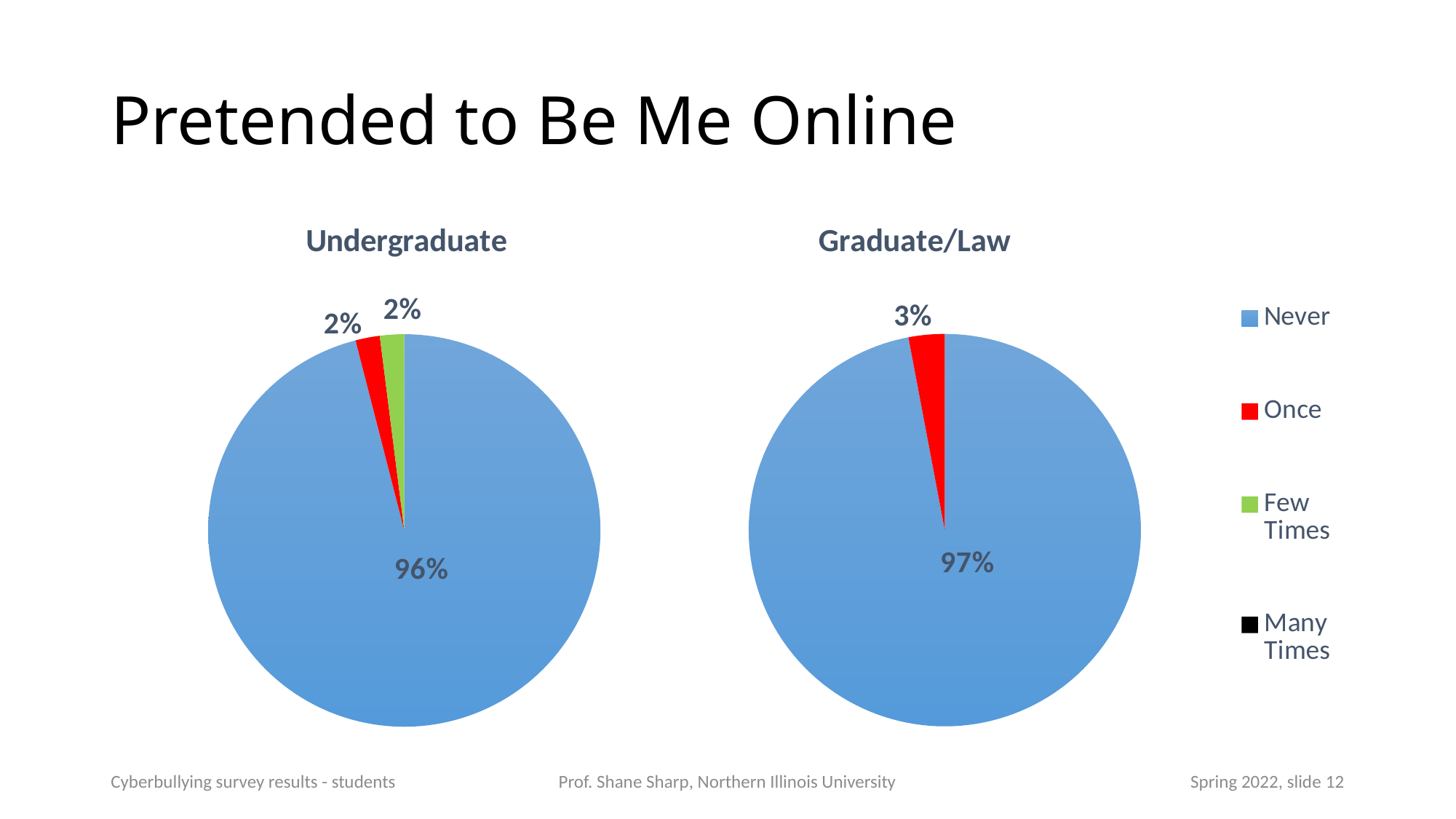
In the Graduate/Law chart, what share of respondents answered Once? 3% In the Undergraduate chart, which category has the largest slice? Never How many categories does the legend list? 4 What colour represents the Once category in the pie charts? Red What is the difference between the Never share in the Graduate/Law chart and the Never share in the Undergraduate chart? 1% In the Undergraduate chart, what share of respondents answered Few Times? 2% In the Graduate/Law chart, what share of respondents answered Never? 97% In the Undergraduate chart, what share of respondents answered Never? 96% Which chart has the larger Never share, Undergraduate or Graduate/Law? Graduate/Law What type of chart is used on this slide? Pie chart In the Graduate/Law chart, which category has the smallest labelled slice? Once In the Undergraduate chart, what share of respondents answered Once? 2%